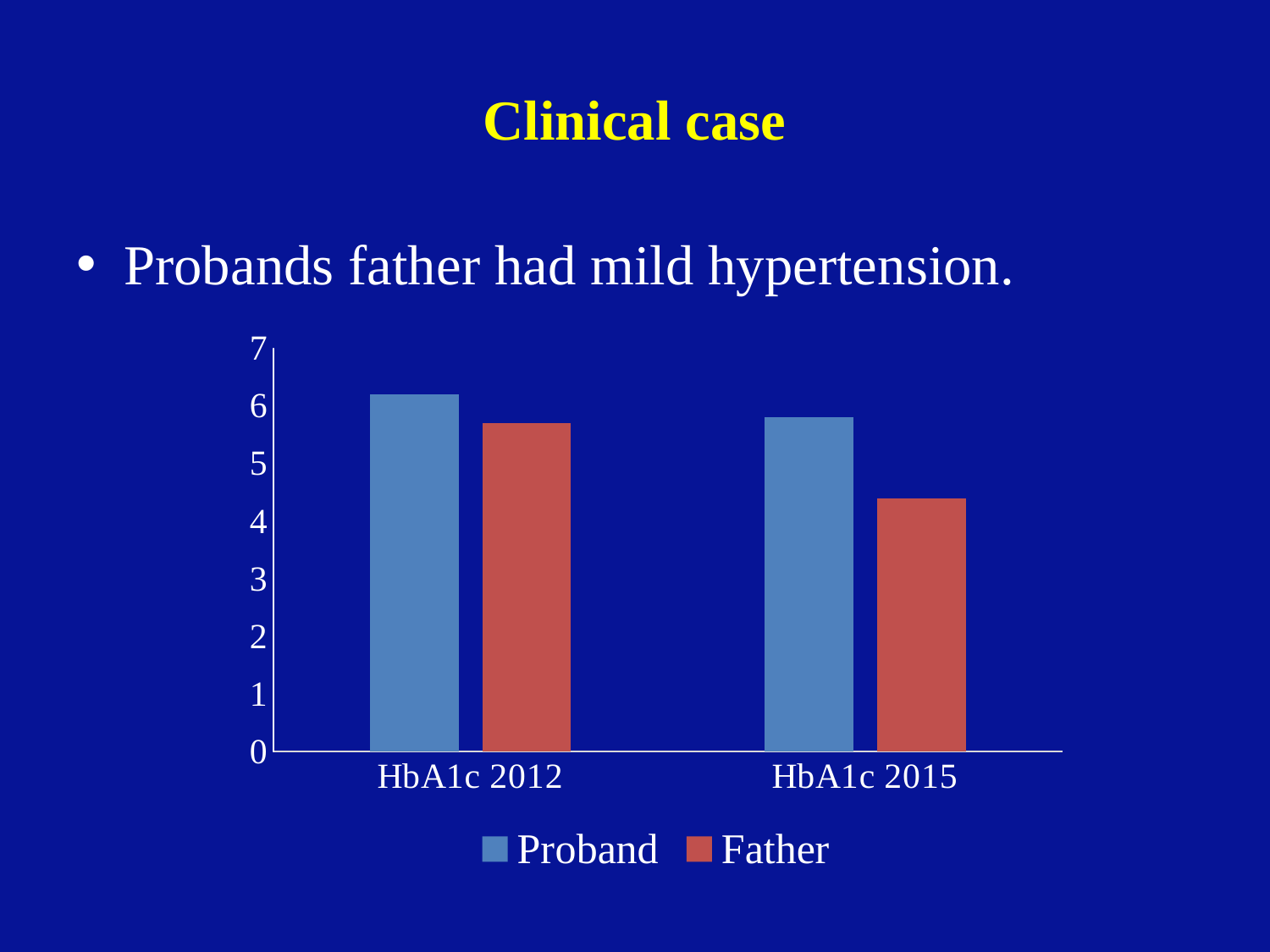
Which bar in the chart is the lowest? Father, HbA1c 2015 Do the Father values rise or fall from HbA1c 2012 to HbA1c 2015? fall For HbA1c 2015, which is larger, the Proband value or the Father value? Proband Which series is shown in red in the chart? Father How many categories are shown on the x axis of the chart? 2 How many series does the chart legend list? 2 Is the Proband value for HbA1c 2012 greater or less than 6? greater For the Father series, which is larger, HbA1c 2012 or HbA1c 2015? HbA1c 2012 What kind of chart is shown on the slide? bar chart Is the Proband value for HbA1c 2015 greater or less than 6? less Is the Father value for HbA1c 2015 greater or less than 5? less